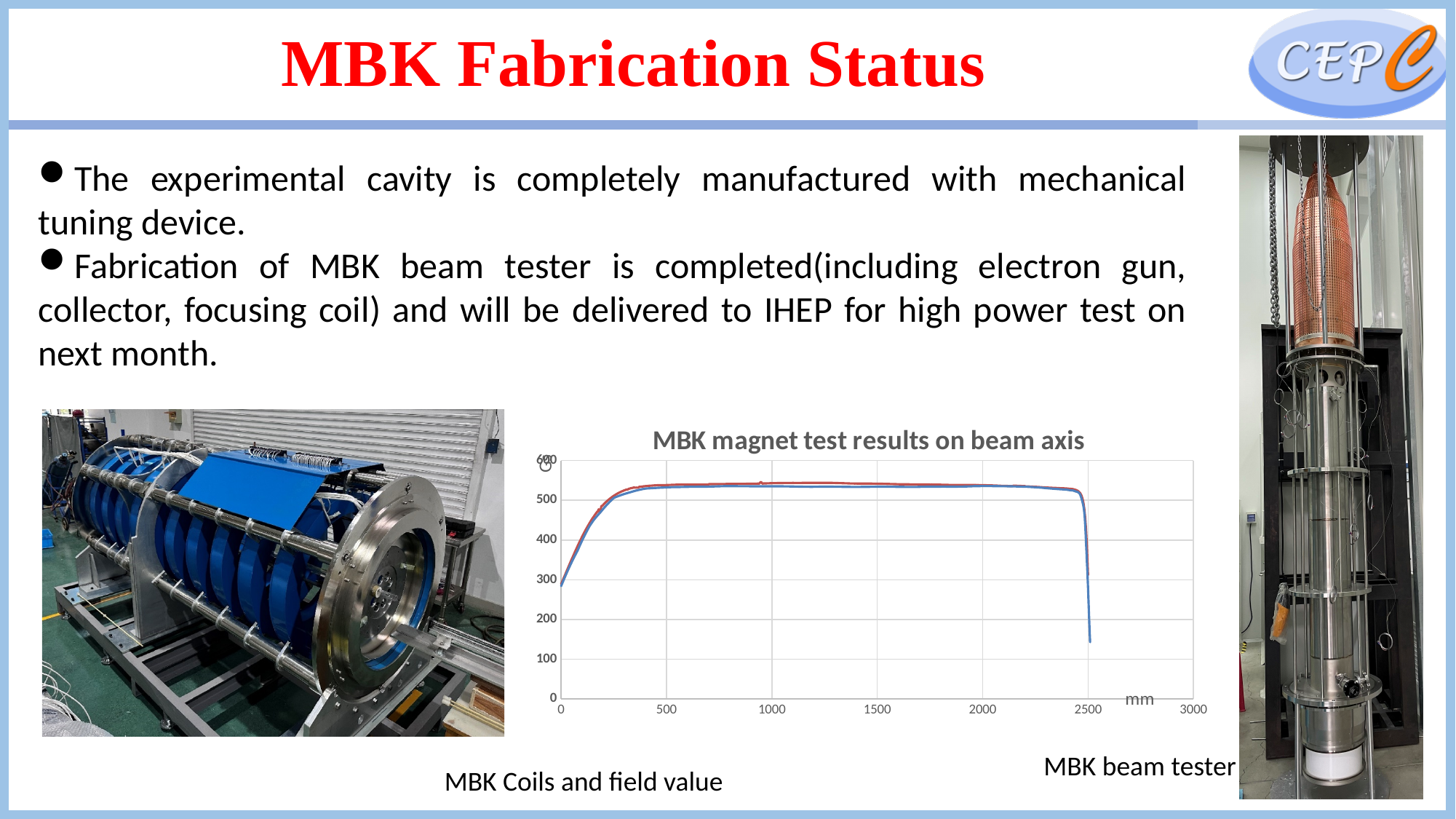
What is the highest tick value shown on the y axis of the chart? 600 How many lines are plotted on the chart? 2 Do the plotted values rise or fall between 2400 mm and 2500 mm? fall Is the plotted value at the far right end of the curve (around 2500 mm) greater or less than 200? less What is the title of the chart on the slide? MBK magnet test results on beam axis What type of chart is shown on the slide? line chart Is the plotted value at 2000 mm greater or less than 500? greater What is the highest tick value shown on the x axis of the chart? 3000 Is the plotted value at 1000 mm greater or less than 500? greater Do the plotted values rise or fall between 0 mm and 500 mm? rise What unit is shown at the end of the x axis of the chart? mm